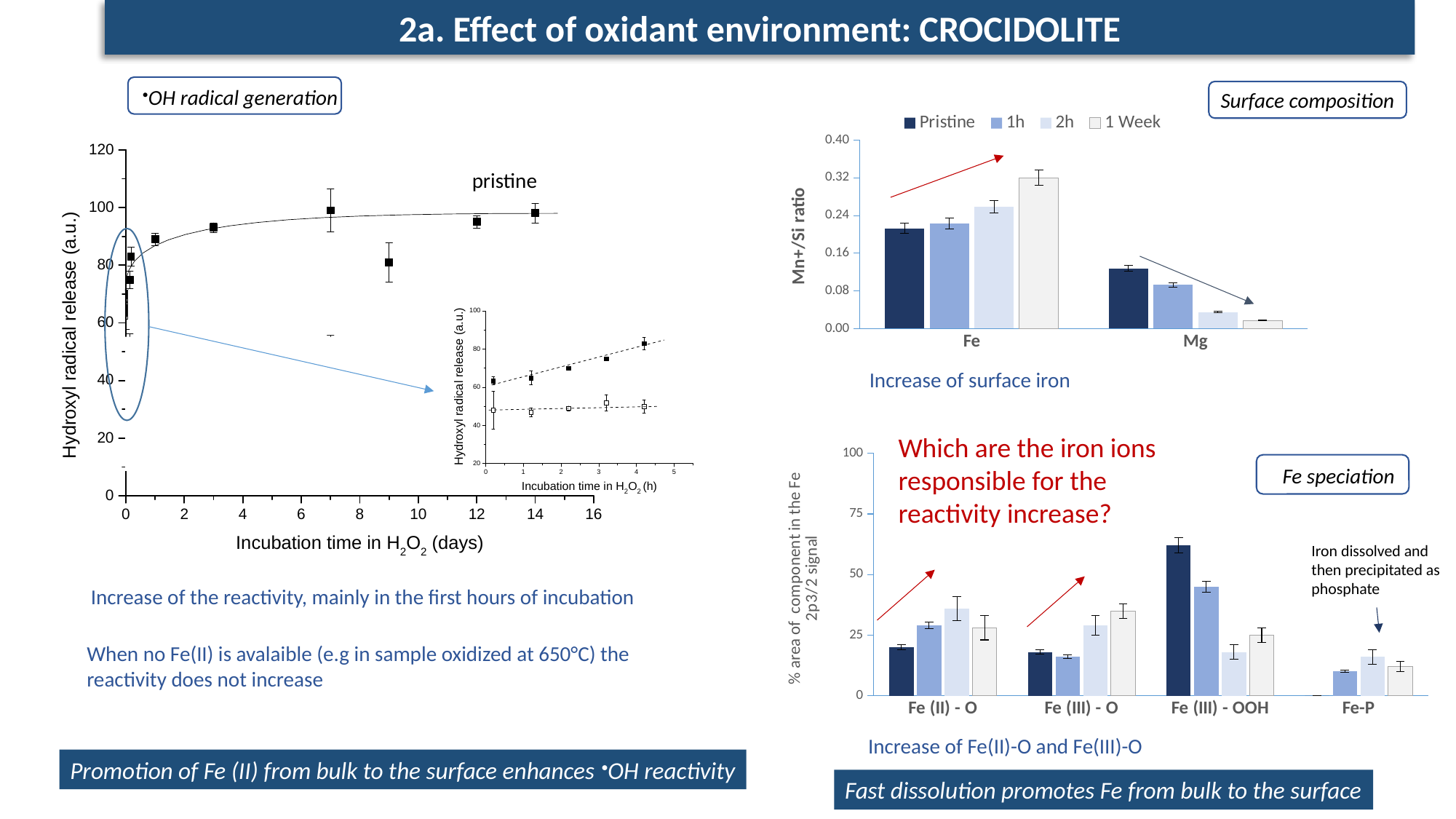
In the OH radical generation chart, what is the label of the x axis? Incubation time in H2O2 (days) In the Surface composition chart, which series has the lowest Mn+/Si ratio for Mg? 1 Week In the Surface composition chart, which is larger: the Pristine value for Fe or the Pristine value for Mg? Fe In the Surface composition chart, is the 1 Week value for Fe greater or less than 0.24? greater In the Surface composition chart, how many series does the legend list? 4 In the OH radical generation chart, is the hydroxyl radical release at 14 days greater or less than 80? greater In the Surface composition chart, is the Pristine value for Mg greater or less than 0.16? less In the Fe speciation chart, how many categories are shown on the x axis? 4 In the Fe speciation chart, which series has the highest value for Fe (III) - OOH? Pristine In the Surface composition chart, which series has the highest Mn+/Si ratio for Fe? 1 Week In the Fe speciation chart, which is larger for Fe (II) - O: the Pristine value or the 2h value? 2h